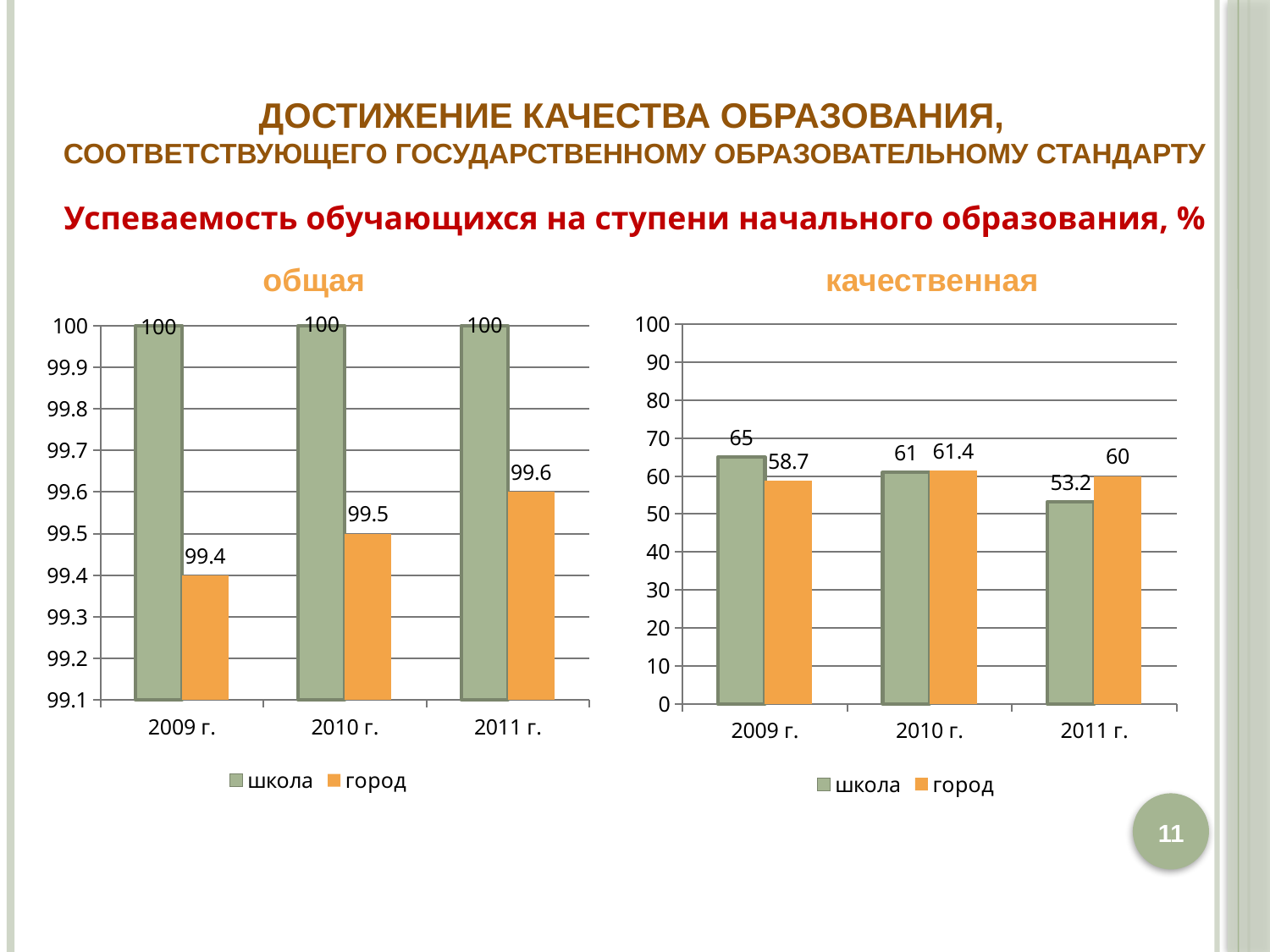
In the 'качественная' chart, what is the difference between 'школа' and 'город' in 2011 г.? 6.8 In the 'качественная' chart, what is the value for 'город' in 2010 г.? 61.4 In the 'качественная' chart, which year has the highest value for 'школа'? 2009 г. What kind of chart is the 'общая' chart? bar chart In the 'общая' chart, what is the value for 'школа' in 2011 г.? 100 How many series does the legend of the 'качественная' chart list? 2 In the 'общая' chart, which year has the lowest value for 'город'? 2009 г. In the 'качественная' chart, what is the value for 'школа' in 2011 г.? 53.2 In the 'качественная' chart, do the values for 'школа' rise or fall from 2009 г. to 2011 г.? fall How many years are shown on the x axis of the 'общая' chart? 3 In the 'общая' chart, what is the value for 'город' in 2009 г.? 99.4 In the 'качественная' chart, which is larger in 2009 г., 'школа' or 'город'? школа